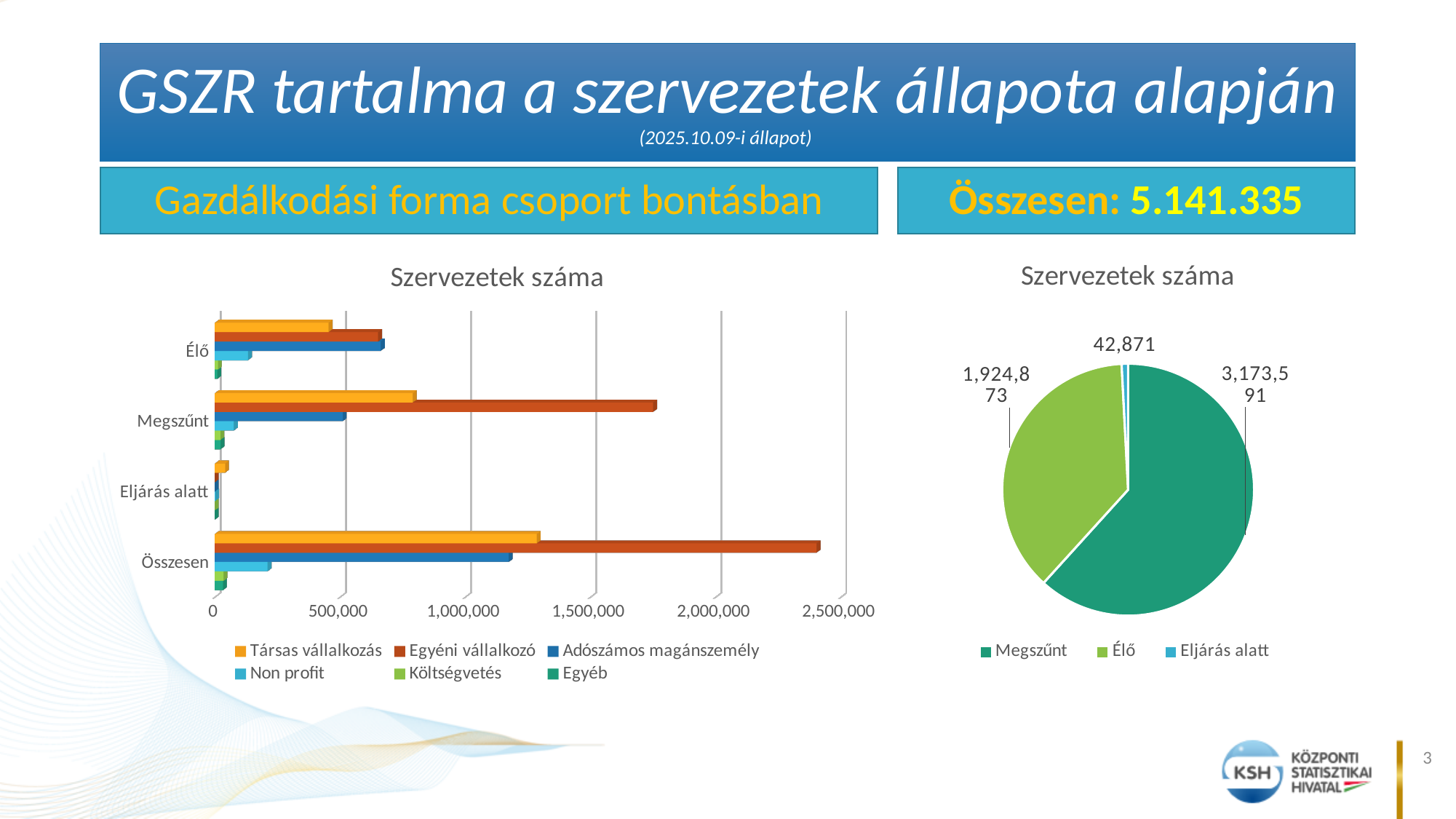
On the pie chart on the right, what is the difference between the Megszűnt and Élő values? 1,248,718 On the pie chart on the right, which slice is the largest? Megszűnt On the pie chart on the right, what is the value for Megszűnt? 3,173,591 On the pie chart on the right, what is the value for Élő? 1,924,873 On the bar chart on the left, is the Társas vállalkozás value for Élő greater or less than 500,000? less On the pie chart on the right, which slice is the smallest? Eljárás alatt What kind of chart is the chart on the left of the slide? Bar chart On the bar chart on the left, which is larger for Megszűnt: Társas vállalkozás or Egyéni vállalkozó? Egyéni vállalkozó On the bar chart on the left, is the Egyéni vállalkozó value for Összesen greater or less than 2,000,000? greater On the pie chart on the right, what is the value for Eljárás alatt? 42,871 On the pie chart on the right, how many slices are there? 3 On the bar chart on the left, how many series does the legend list? 6